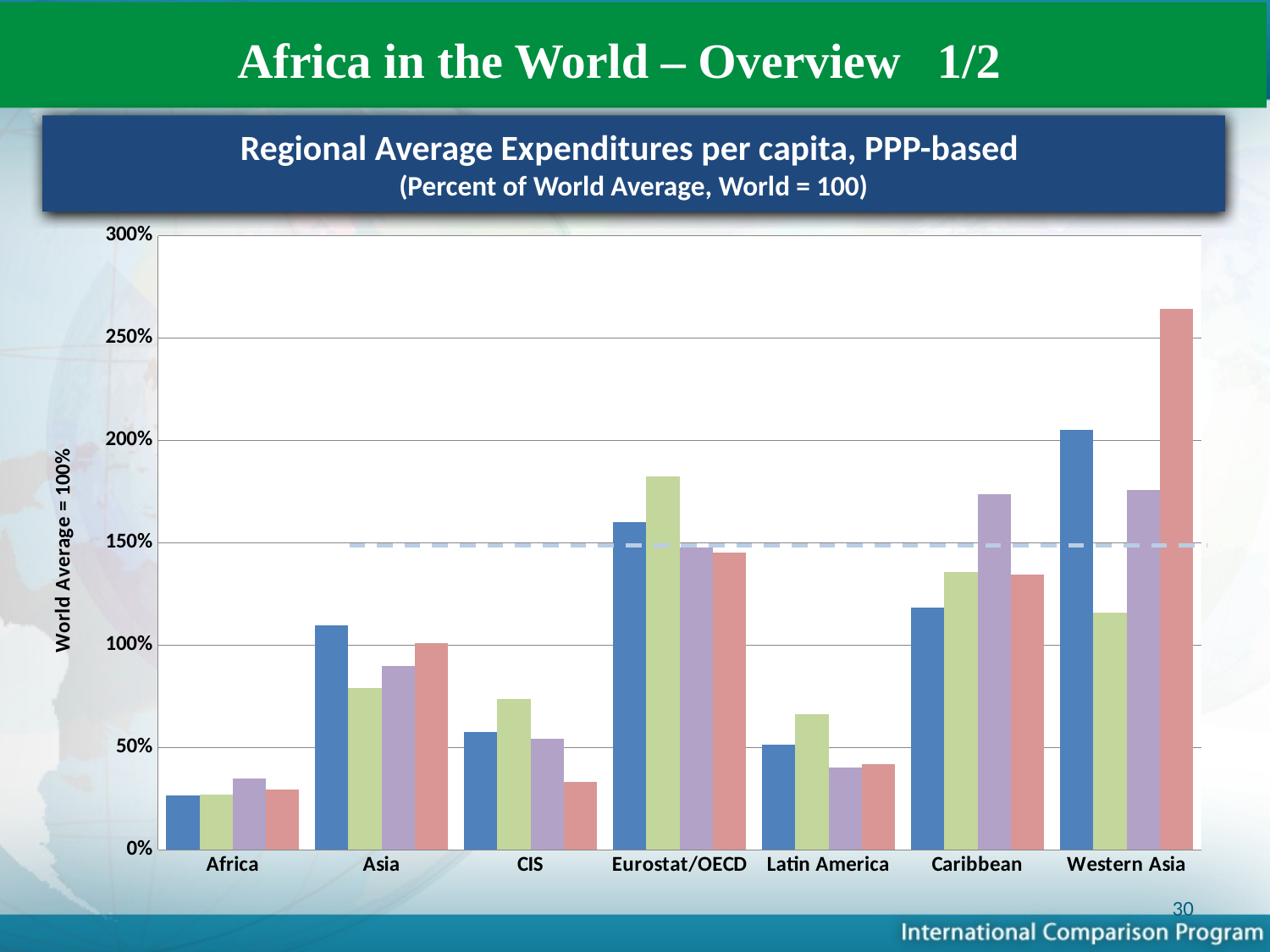
How many regions are shown along the x axis of the chart? 7 What is the title of the chart? Regional Average Expenditures per capita, PPP-based Which is larger, the blue bar for Eurostat/OECD or the blue bar for Latin America? Eurostat/OECD Which region has the lowest bars in the chart? Africa Is the red bar for CIS greater or less than 50%? less Is the green bar for Eurostat/OECD greater or less than 150%? greater Is the blue bar for Asia greater or less than 100%? greater Which is larger, the red bar for Western Asia or the red bar for Caribbean? Western Asia Which region has the tallest bar in the chart? Western Asia What is the label on the vertical axis of the chart? World Average = 100% What kind of chart is shown on the slide? bar chart